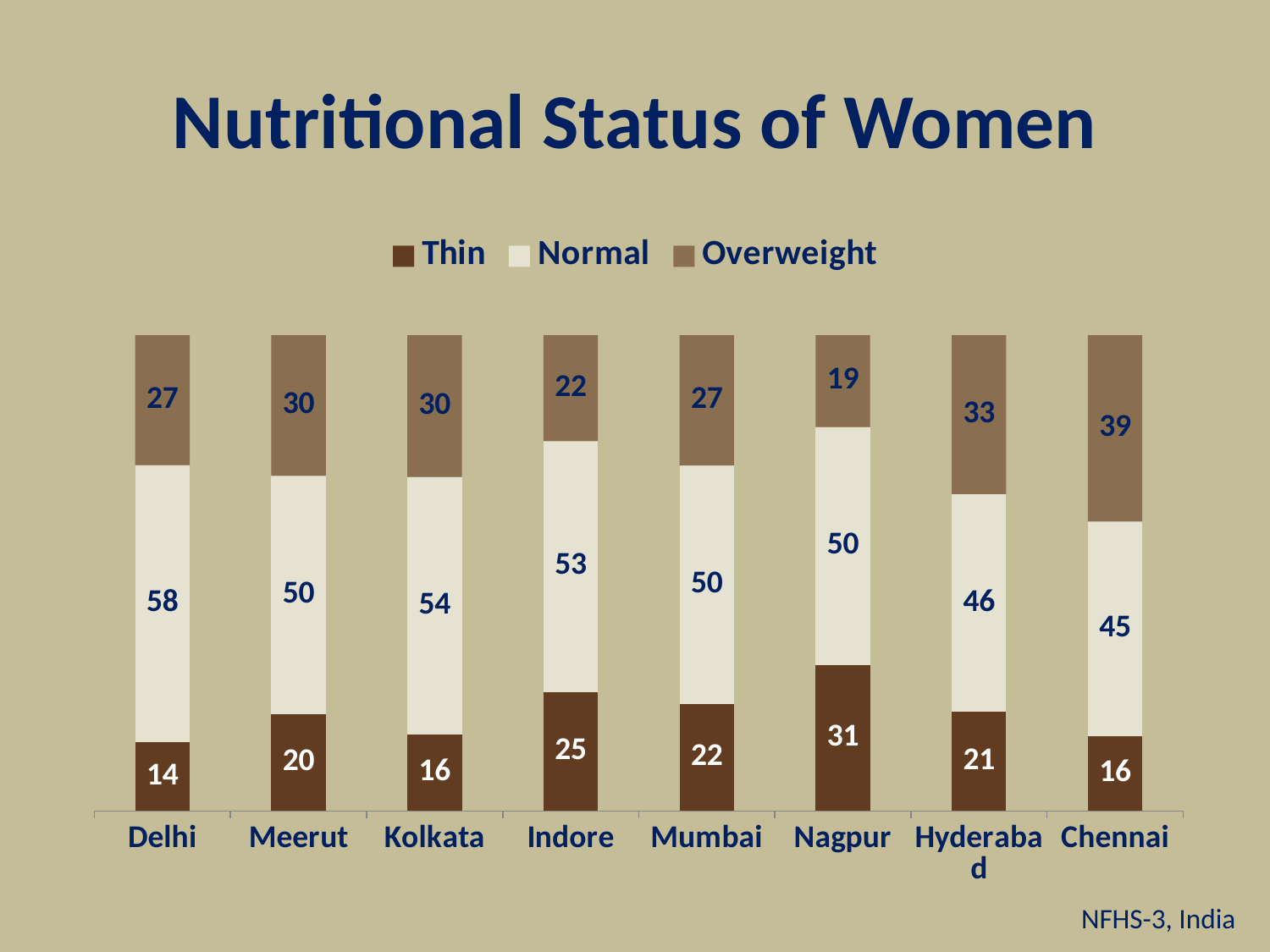
How many cities are shown on the x axis? 8 What is the Thin value for Nagpur? 31 Which has the larger Overweight value, Meerut or Indore? Meerut What is the difference between the Normal value for Delhi and the Normal value for Chennai? 13 Which city has the lowest Thin value? Delhi Which city has the lowest Overweight value? Nagpur What is the Normal value for Chennai? 45 Which city has the highest Overweight value? Chennai How many series does the legend list? 3 What is the Overweight value for Hyderabad? 33 Which city has the highest Thin value? Nagpur What kind of chart is shown on the slide? Stacked bar chart